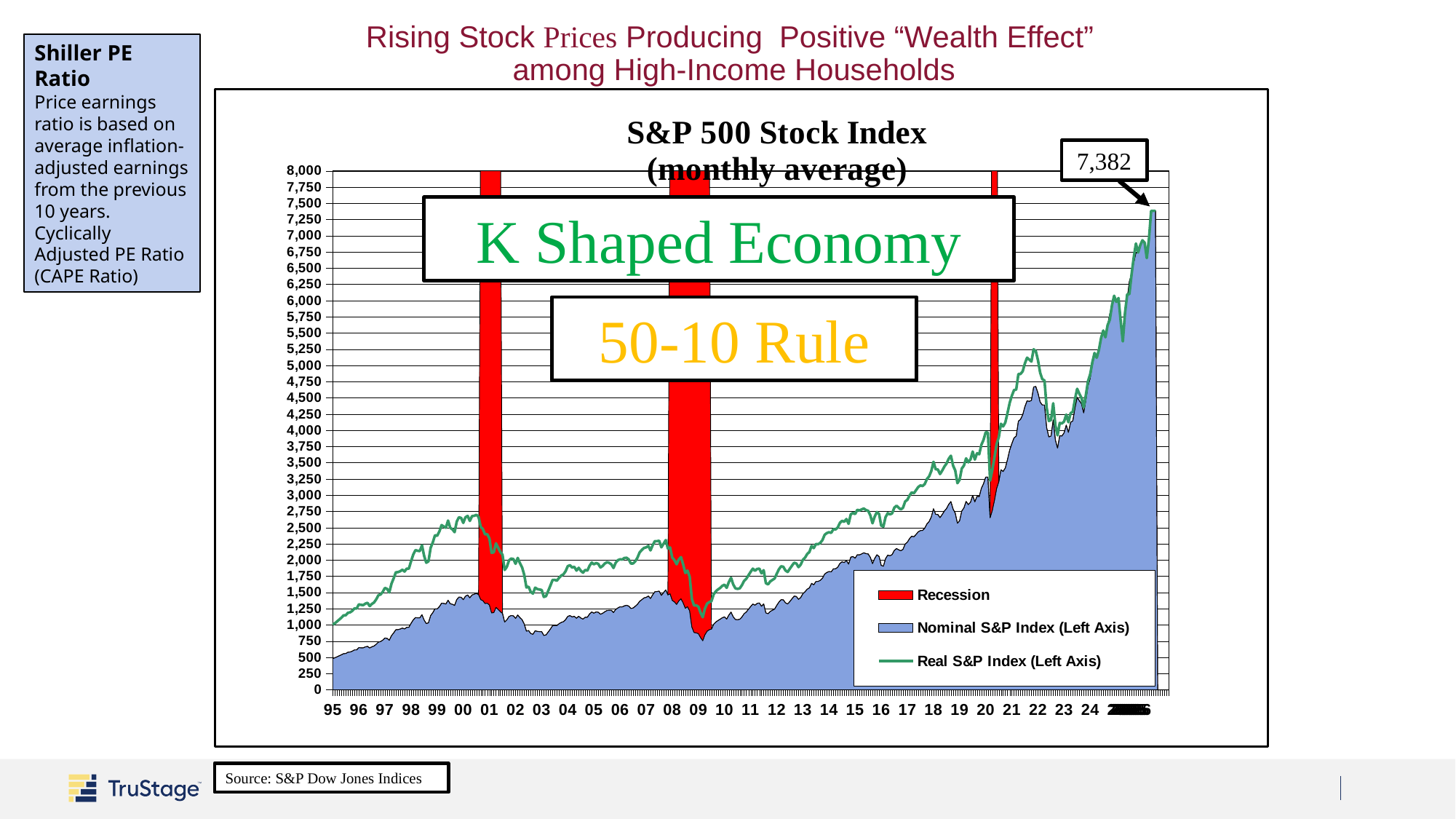
In 09, which series is higher: the Real S&P Index or the Nominal S&P Index? Real S&P Index Is the Nominal S&P Index value in 95 greater or less than 1,000? less Is the Nominal S&P Index peak around 22 greater or less than 4,000? greater Does the Nominal S&P Index generally rise or fall from 95 to 24? rise How many recession bars are shaded on the chart? 3 Is the peak of the Real S&P Index around 00 greater or less than 2,500? greater How many entries does the chart's legend list? 3 What source is cited for the chart? S&P Dow Jones Indices What value is printed in the callout at the end of the Nominal S&P Index series? 7,382 What is the title of the chart? S&P 500 Stock Index (monthly average)